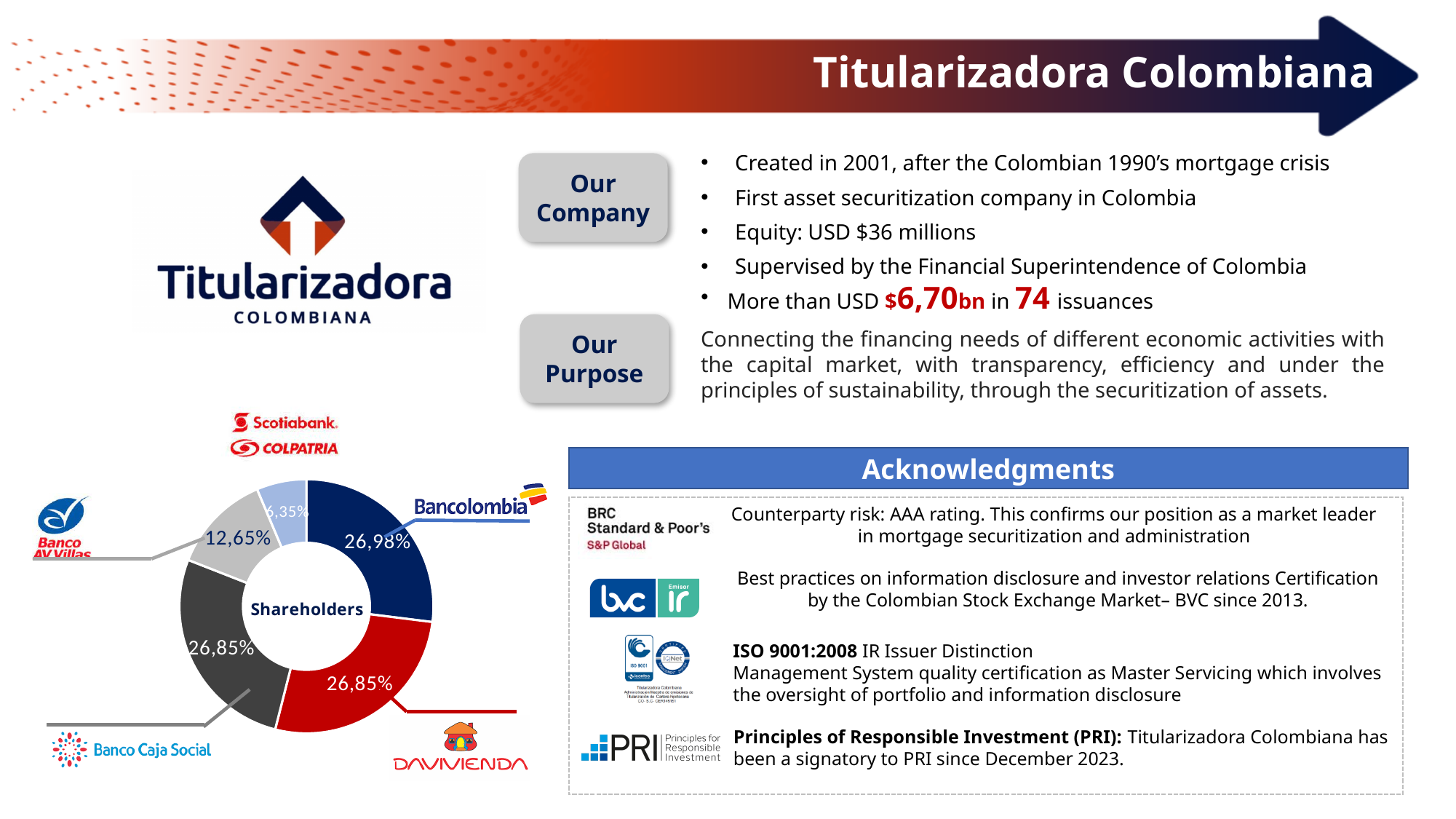
What percentage is shown for Scotiabank Colpatria in the Shareholders chart? 6,35% How many shareholders are shown as slices in the Shareholders chart? 5 In the Shareholders chart, what is the difference between Banco AV Villas' share and Scotiabank Colpatria's share? 6,30% What is the value shown for Banco AV Villas in the Shareholders chart? 12,65% What kind of chart is used to show the shareholders? Pie (donut) chart In the Shareholders chart, which is larger: Banco AV Villas' share or Banco Caja Social's share? Banco Caja Social What share does Davivienda hold according to the Shareholders chart? 26,85% What share of the Shareholders chart does Bancolombia hold? 26,98% Which shareholder has the largest slice in the Shareholders chart? Bancolombia In the Shareholders chart, what is the difference between Bancolombia's share and Davivienda's share? 0,13% Which shareholder has the smallest slice in the Shareholders chart? Scotiabank Colpatria What title is printed in the centre of the pie chart? Shareholders